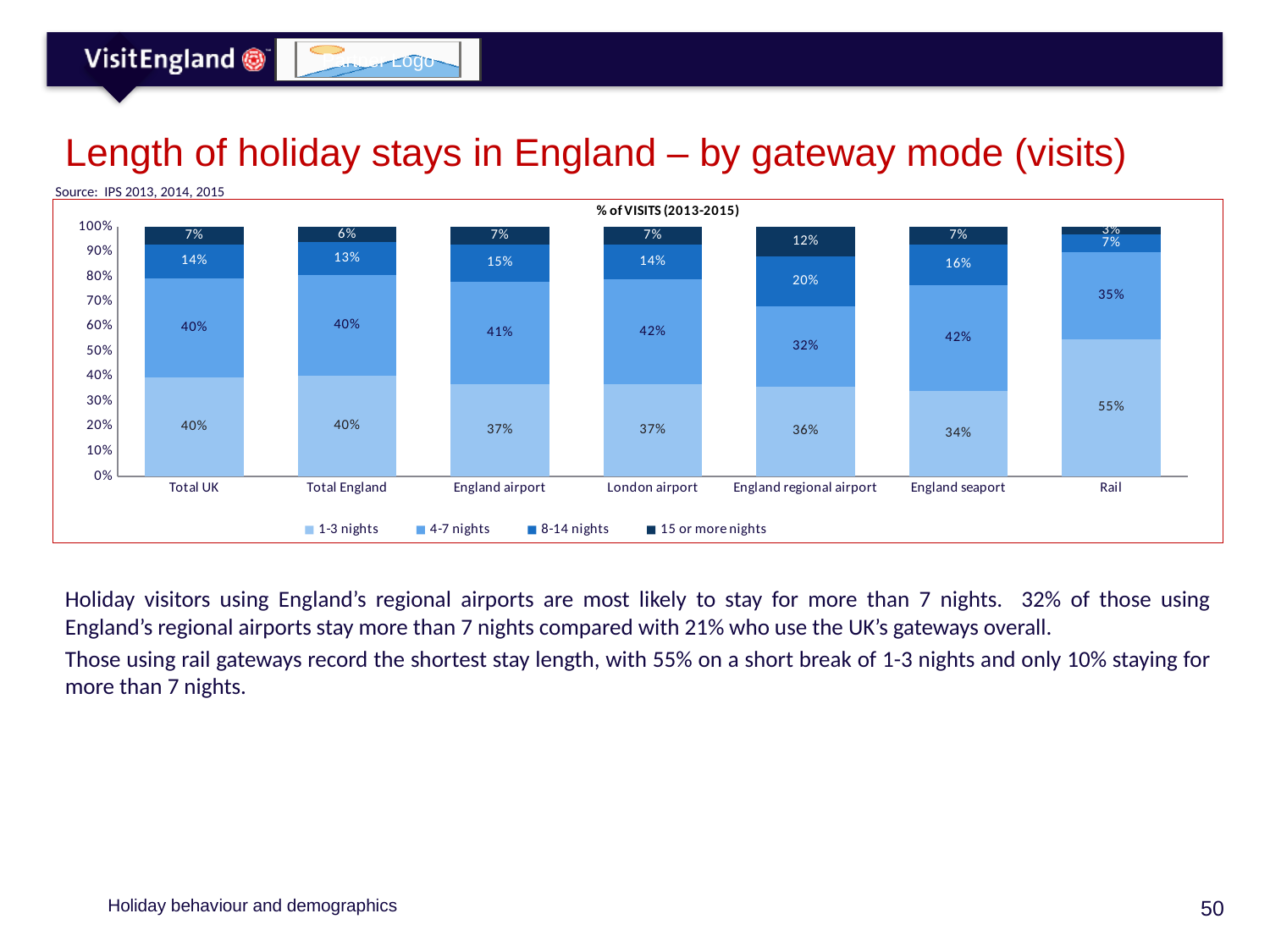
What percentage of visits via Rail are 1-3 nights? 55% Which is larger: the 4-7 nights share for London airport or for England regional airport? London airport Which gateway mode has the lowest share of 1-3 night visits? England seaport What is the difference in percentage points between the 1-3 nights share for Rail and for Total UK? 15 What percentage of visits via England regional airport are 15 or more nights? 12% What percentage of visits via England seaport are 4-7 nights? 42% How many series does the legend list? 4 How many gateway mode categories are shown on the x axis? 7 What type of chart is shown on the slide? Stacked bar chart What percentage of visits for Total UK are 8-14 nights? 14% Which gateway mode has the highest share of 1-3 night visits? Rail Which gateway mode has the highest share of 8-14 night visits? England regional airport